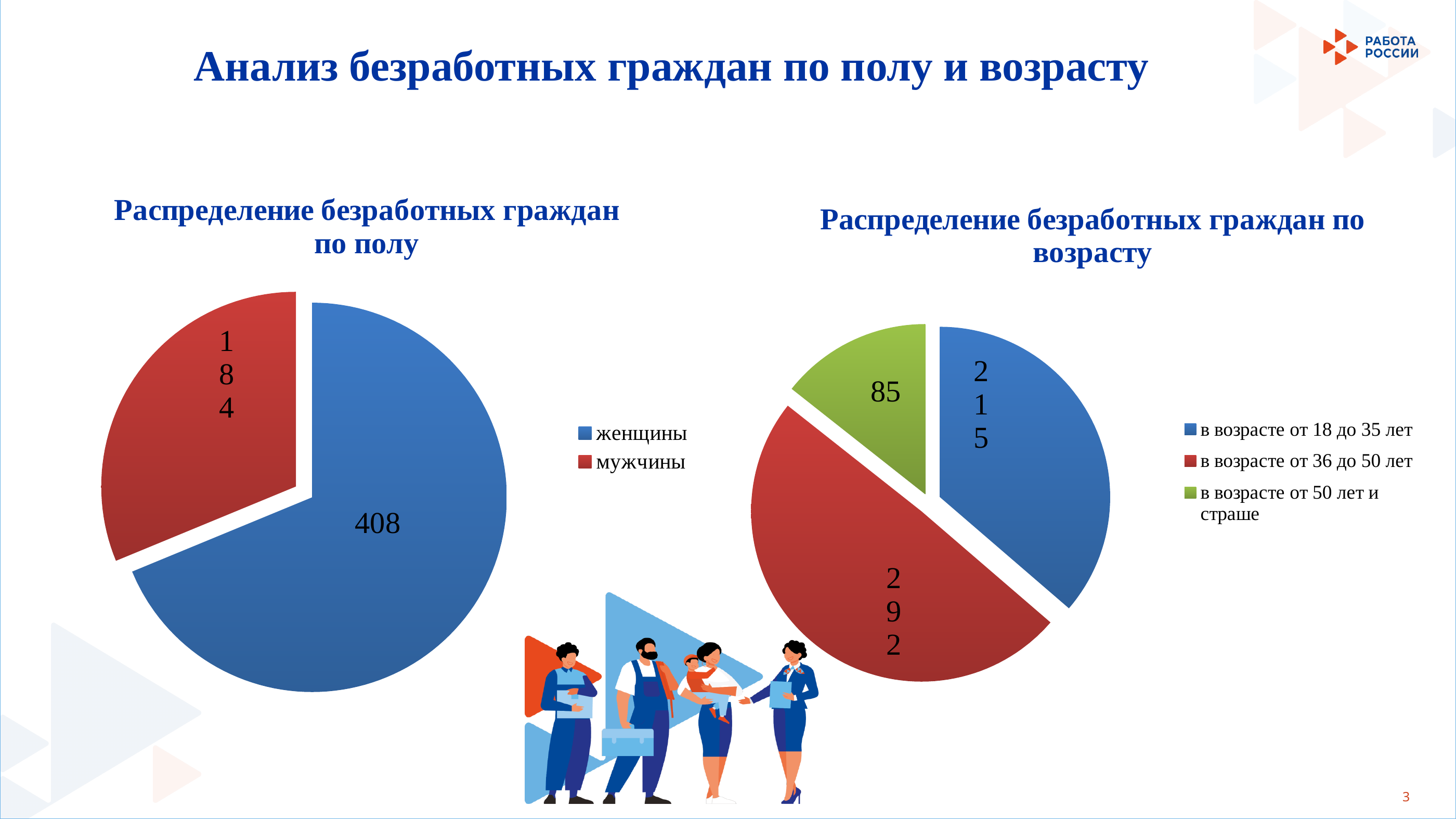
In the chart 'Распределение безработных граждан по полу', what is the total of all slices? 592 In the chart 'Распределение безработных граждан по возрасту', what is the difference between the values for 'в возрасте от 36 до 50 лет' and 'в возрасте от 18 до 35 лет'? 77 In the chart 'Распределение безработных граждан по возрасту', which colour represents 'в возрасте от 50 лет и страше'? green In the chart 'Распределение безработных граждан по возрасту', which age group has the highest value? в возрасте от 36 до 50 лет In the chart 'Распределение безработных граждан по возрасту', how many categories does the legend list? 3 In the chart 'Распределение безработных граждан по полу', what kind of chart is shown? pie chart In the chart 'Распределение безработных граждан по полу', what is the difference between the values for женщины and мужчины? 224 In the chart 'Распределение безработных граждан по возрасту', what is the value for 'в возрасте от 50 лет и страше'? 85 In the chart 'Распределение безработных граждан по возрасту', what is the value for 'в возрасте от 36 до 50 лет'? 292 In the chart 'Распределение безработных граждан по возрасту', which age group has the lowest value? в возрасте от 50 лет и страше In the chart 'Распределение безработных граждан по полу', what is the value for мужчины? 184 In the chart 'Распределение безработных граждан по полу', what is the value for женщины? 408